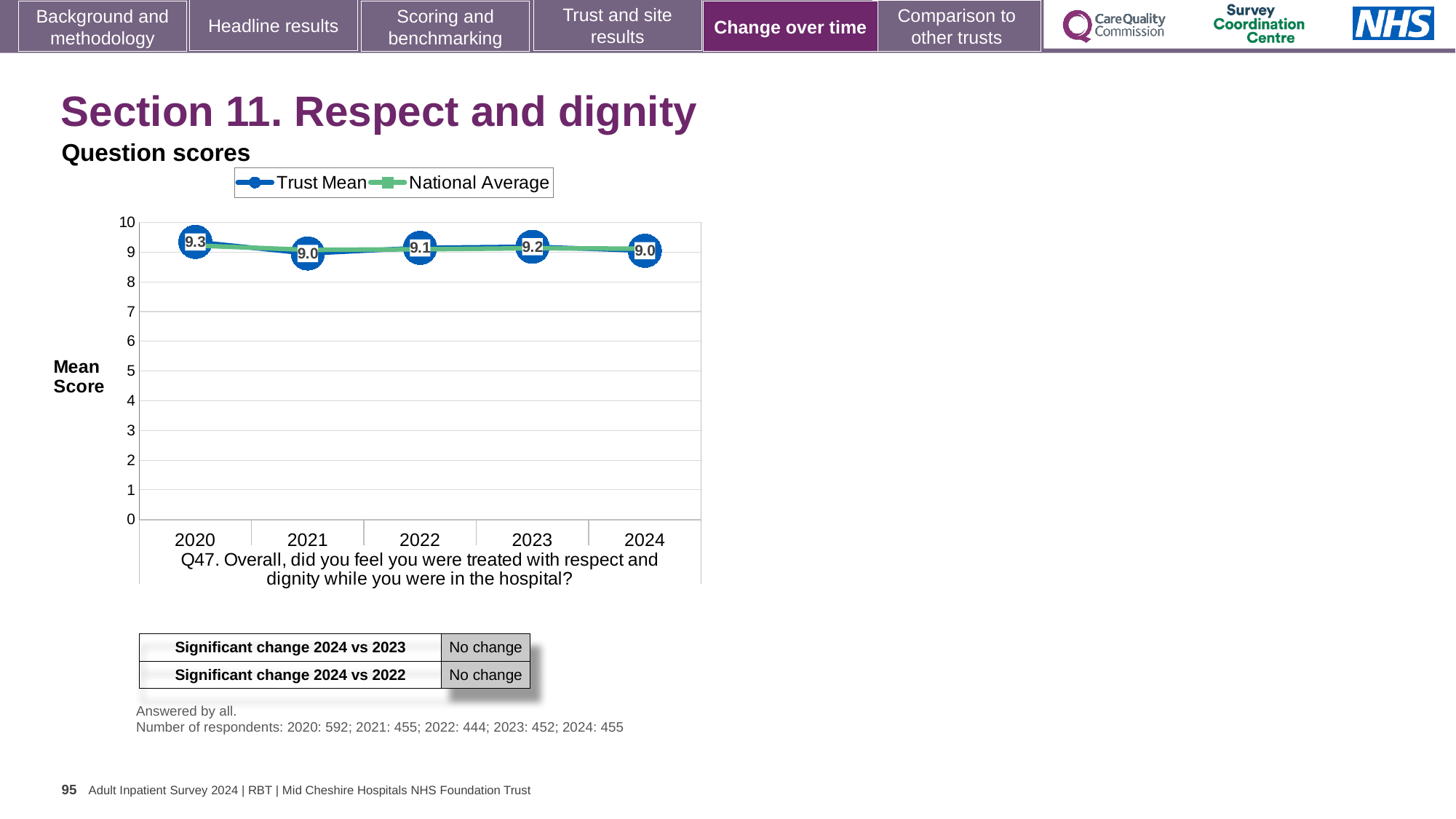
What is the Trust Mean score for 2020? 9.3 What is the label on the y axis of the chart? Mean Score How many years are plotted on the x axis? 5 In which year is the Trust Mean score highest? 2020 How many series does the legend list? 2 What is the lowest Trust Mean score shown on the chart? 9.0 What is the Trust Mean score for 2023? 9.2 What kind of chart is shown on the slide? line chart What is the Trust Mean score for 2024? 9.0 What is the difference between the Trust Mean scores for 2020 and 2021? 0.3 Which year has the larger Trust Mean score, 2022 or 2023? 2023 Is the National Average value for 2024 greater or less than 5? greater